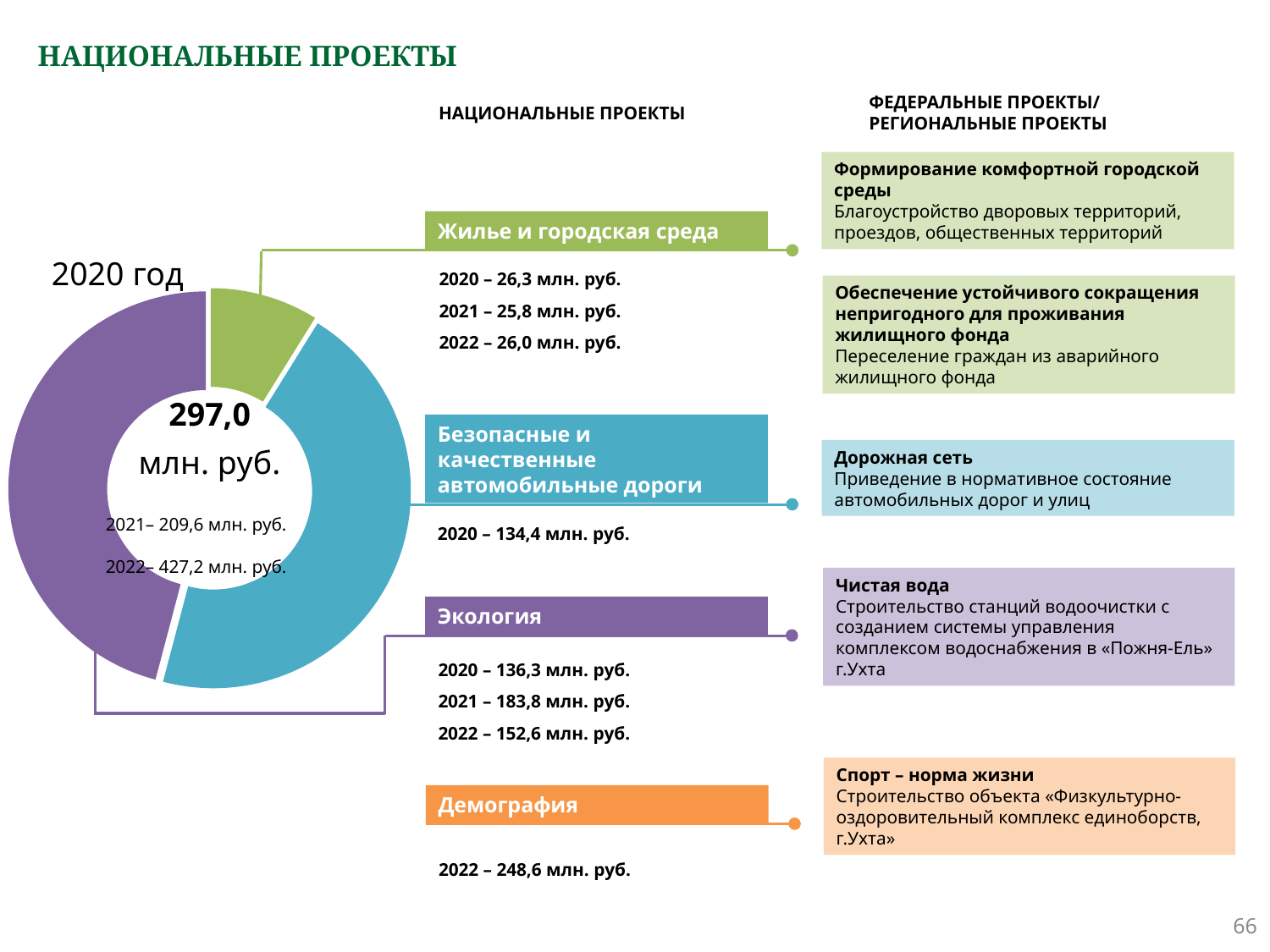
Which colour represents Экология in the donut chart? Purple What is the 2020 value for Экология? 136,3 млн. руб. Which year does the donut chart represent? 2020 год What total value is printed in the centre of the donut chart? 297,0 млн. руб. Which national project has the smallest slice in the 2020 donut chart? Жилье и городская среда What is the 2020 value for Жилье и городская среда? 26,3 млн. руб. What is the 2020 value for Безопасные и качественные автомобильные дороги? 134,4 млн. руб. Which national project has the largest slice in the 2020 donut chart? Экология How many slices does the donut chart have? 3 What kind of chart is shown on the slide? Donut (pie) chart Which is larger in 2020: Экология or Безопасные и качественные автомобильные дороги? Экология What is the difference between the 2020 values for Экология and Безопасные и качественные автомобильные дороги? 1,9 млн. руб.